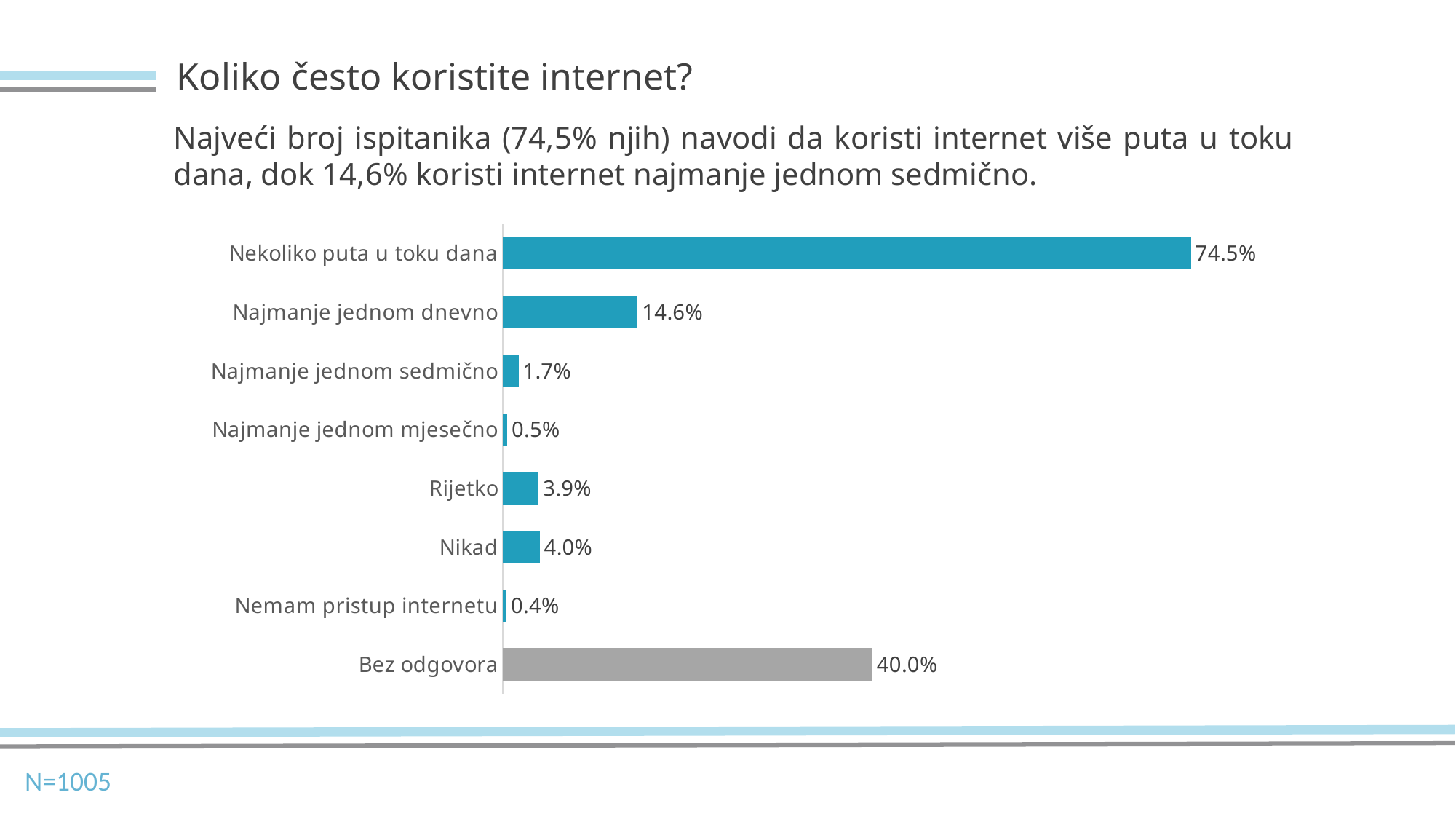
What is the difference between "Bez odgovora" and "Najmanje jednom dnevno"? 25.4% Which category has the lowest value? Nemam pristup internetu What kind of chart is shown on the slide? Bar chart What is the value for "Nekoliko puta u toku dana"? 74.5% Which is larger, the value for "Rijetko" or the value for "Nikad"? Nikad What is the value for "Najmanje jednom dnevno"? 14.6% Which category has the highest value? Nekoliko puta u toku dana What is the value for "Nikad"? 4.0% What colour is the bar for "Bez odgovora"? Grey How many categories are shown in the chart? 8 What is the difference between "Nekoliko puta u toku dana" and "Najmanje jednom dnevno"? 59.9% What is the value for "Bez odgovora"? 40.0%